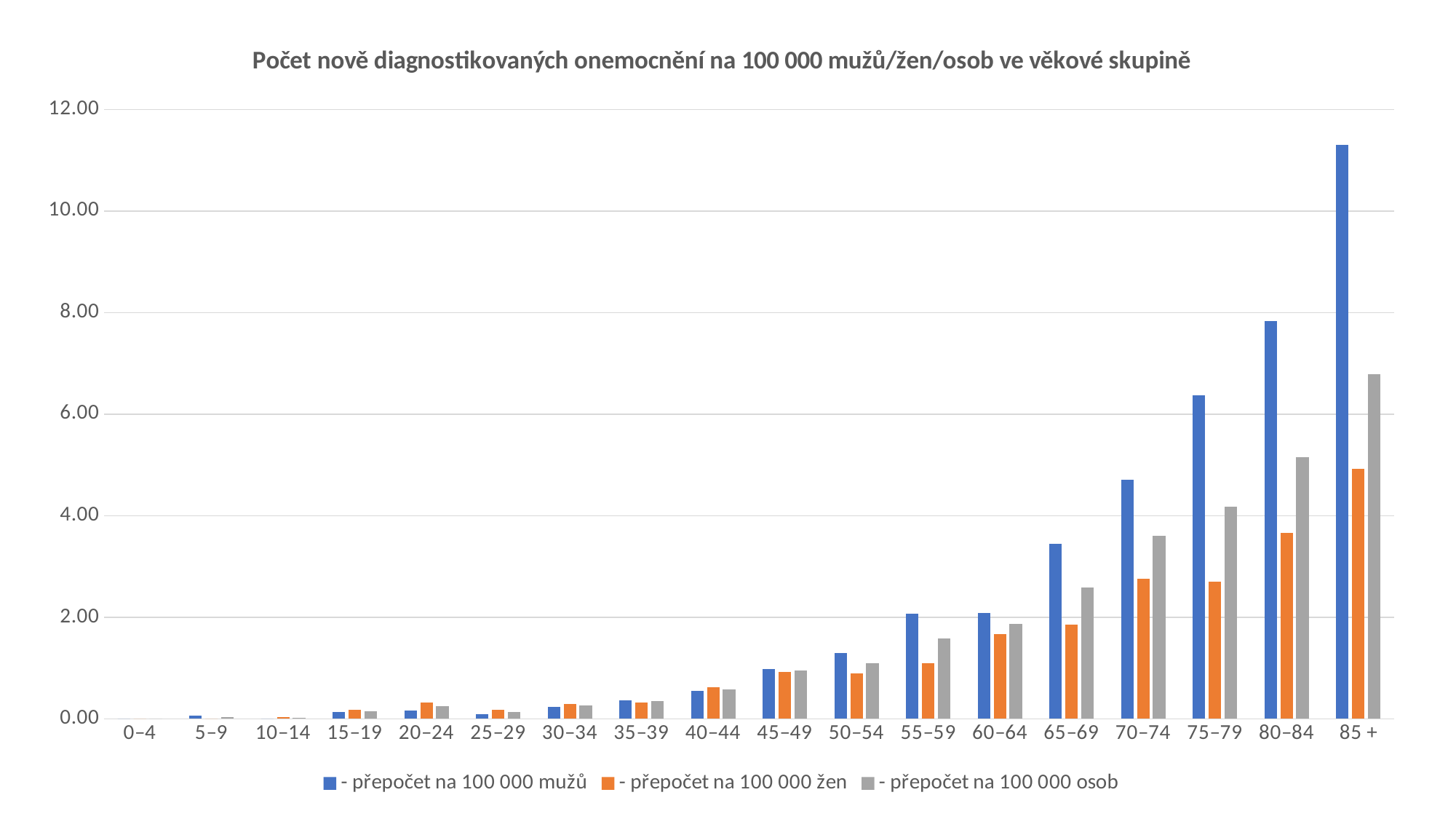
How many age groups are shown on the x axis? 18 Do the values for '- přepočet na 100 000 mužů' generally rise or fall as the age groups increase along the x axis? rise Which age group has the highest value for the series '- přepočet na 100 000 mužů'? 85 + In the 85 + age group, which is larger: the value for '- přepočet na 100 000 mužů' or for '- přepočet na 100 000 žen'? - přepočet na 100 000 mužů How many series does the legend list? 3 Is the value for '- přepočet na 100 000 osob' in the 85 + age group greater or less than 6.00? greater Is the value for '- přepočet na 100 000 mužů' in the 70–74 age group greater or less than 4.00? greater What colour are the bars for the series '- přepočet na 100 000 žen'? orange Is the value for '- přepočet na 100 000 mužů' in the 85 + age group greater or less than 10.00? greater What kind of chart is shown on the slide? bar chart